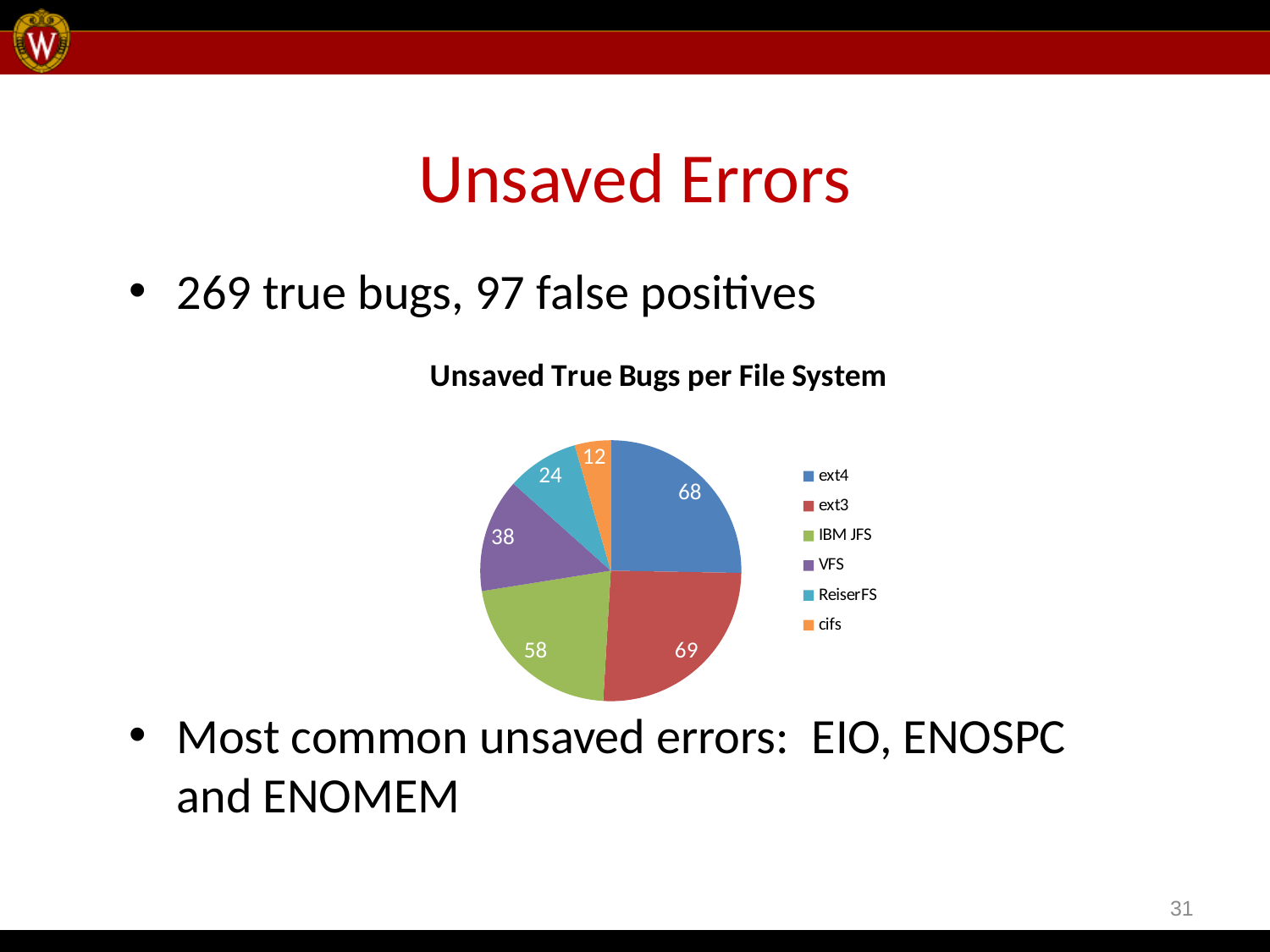
What is the value for IBM JFS in the pie chart? 58 Which has a larger value, ReiserFS or cifs? ReiserFS What is the value for VFS in the pie chart? 38 What is the title of the chart? Unsaved True Bugs per File System Which file system has the smallest slice in the pie chart? cifs What kind of chart is shown on the slide? Pie chart What is the difference between the values for ext4 and VFS? 30 What is the difference between the values for IBM JFS and ReiserFS? 34 Which has a larger value, IBM JFS or VFS? IBM JFS What is the value for ReiserFS in the pie chart? 24 How many file systems are shown in the pie chart? 6 What is the value for ext4 in the pie chart? 68